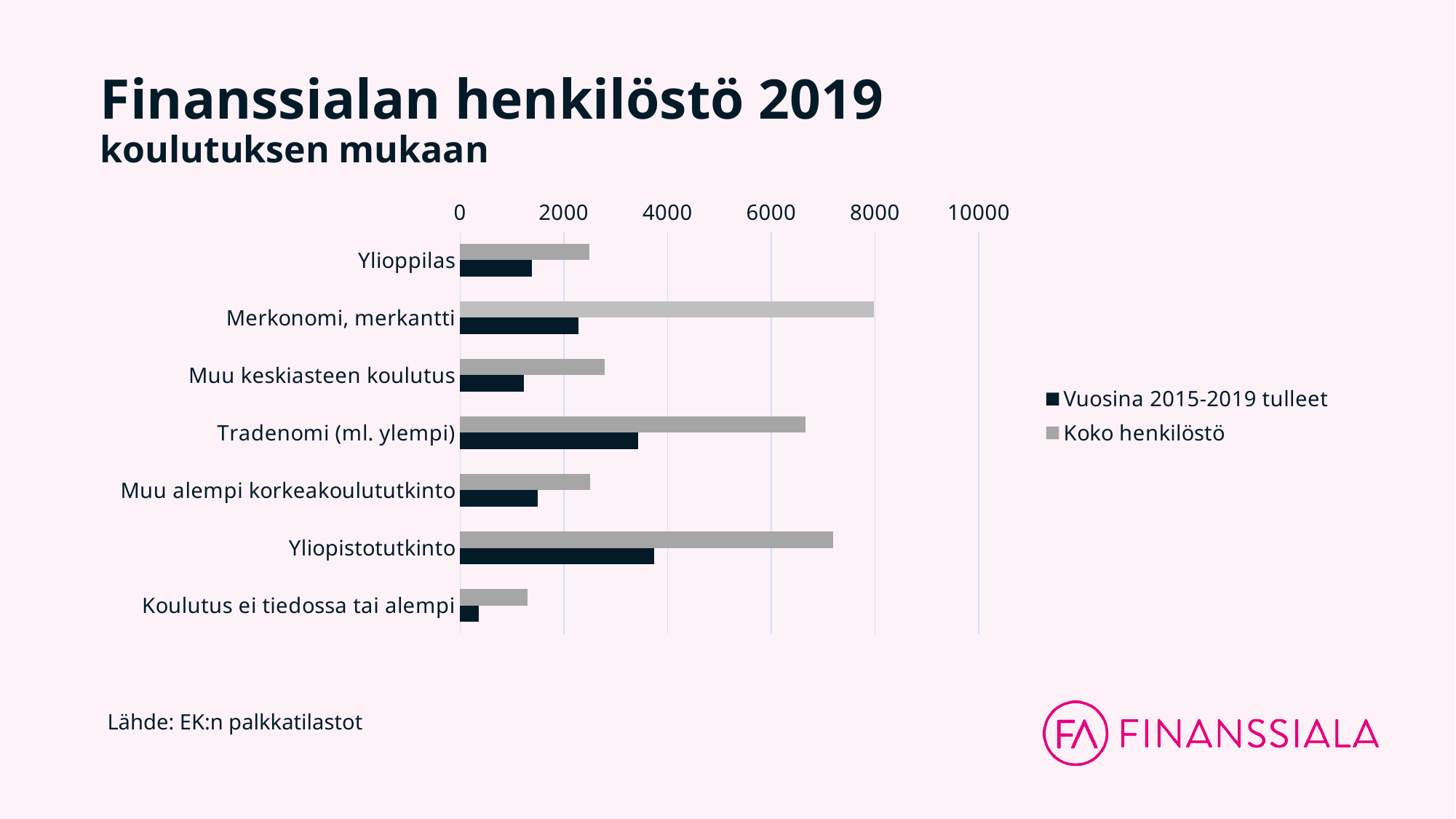
Which category has the lowest value for Koko henkilöstö? Koulutus ei tiedossa tai alempi How many education categories are shown on the chart? 7 Which category has the highest value for Koko henkilöstö? Merkonomi, merkantti What kind of chart is shown on the slide? bar chart How many series does the legend list? 2 Which category has the highest value for Vuosina 2015-2019 tulleet? Yliopistotutkinto Which category has the lowest value for Vuosina 2015-2019 tulleet? Koulutus ei tiedossa tai alempi Is the Koko henkilöstö value for Muu keskiasteen koulutus greater or less than 2000? greater Which is larger: the Koko henkilöstö value for Tradenomi (ml. ylempi) or for Yliopistotutkinto? Yliopistotutkinto Is the Koko henkilöstö value for Yliopistotutkinto greater or less than 6000? greater What is the title of the chart on the slide? Finanssialan henkilöstö 2019 koulutuksen mukaan Is the Vuosina 2015-2019 tulleet value for Tradenomi (ml. ylempi) greater or less than 4000? less